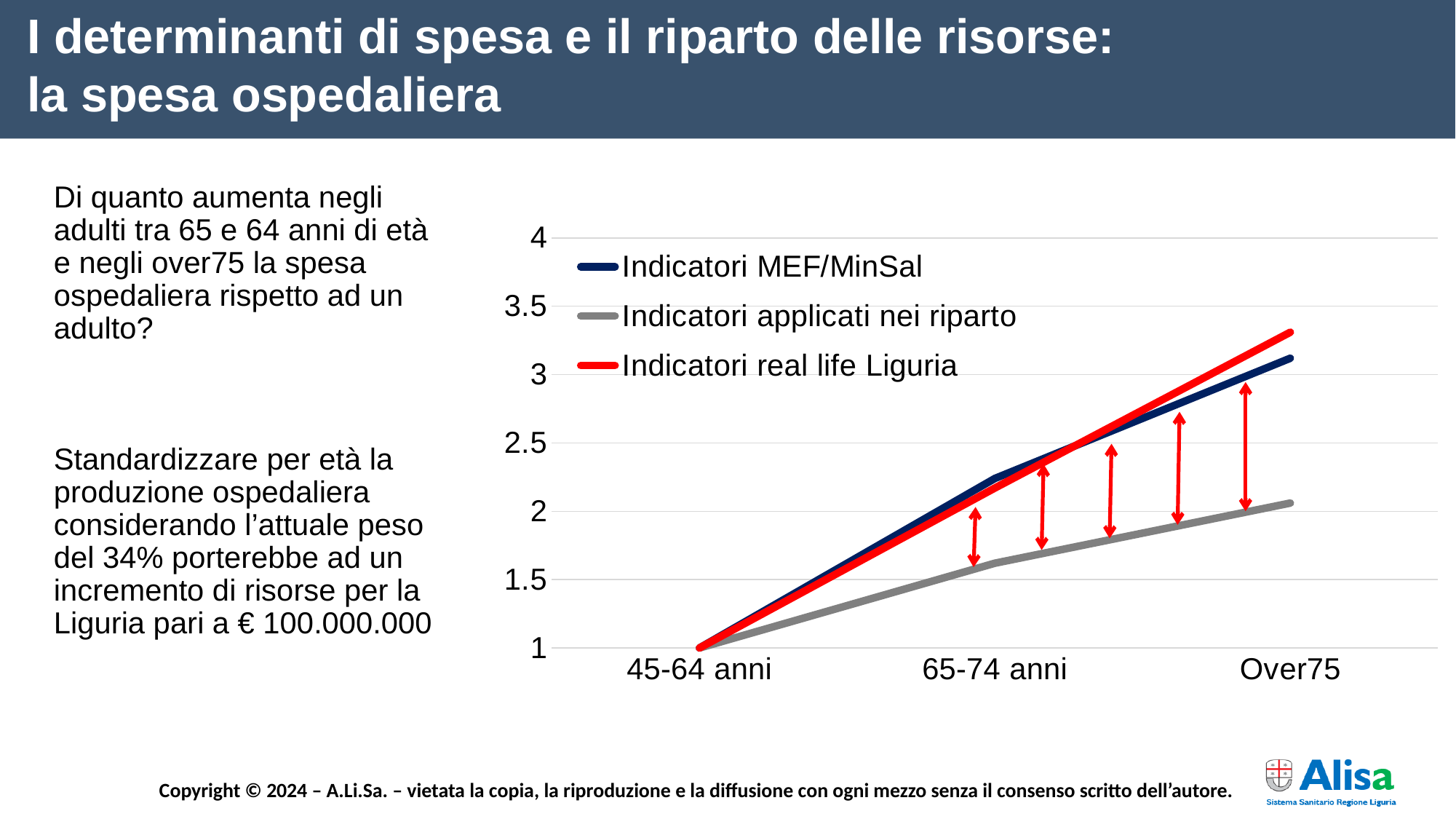
Is the value of Indicatori real life Liguria at Over75 greater or less than 3? greater Which series is drawn in red? Indicatori real life Liguria Is the value of Indicatori applicati nei riparto at 65-74 anni greater or less than 2? less Which series is drawn in grey? Indicatori applicati nei riparto Do the values of the Indicatori real life Liguria series rise or fall from 45-64 anni to Over75? rise What kind of chart is shown on the slide? line chart How many age categories are shown on the x axis? 3 Is the value of Indicatori applicati nei riparto at Over75 greater or less than 2.5? less How many series does the legend list? 3 Which series has the lowest value at Over75? Indicatori applicati nei riparto What is the value of all three series at 45-64 anni? 1 At Over75, which is larger: Indicatori real life Liguria or Indicatori applicati nei riparto? Indicatori real life Liguria